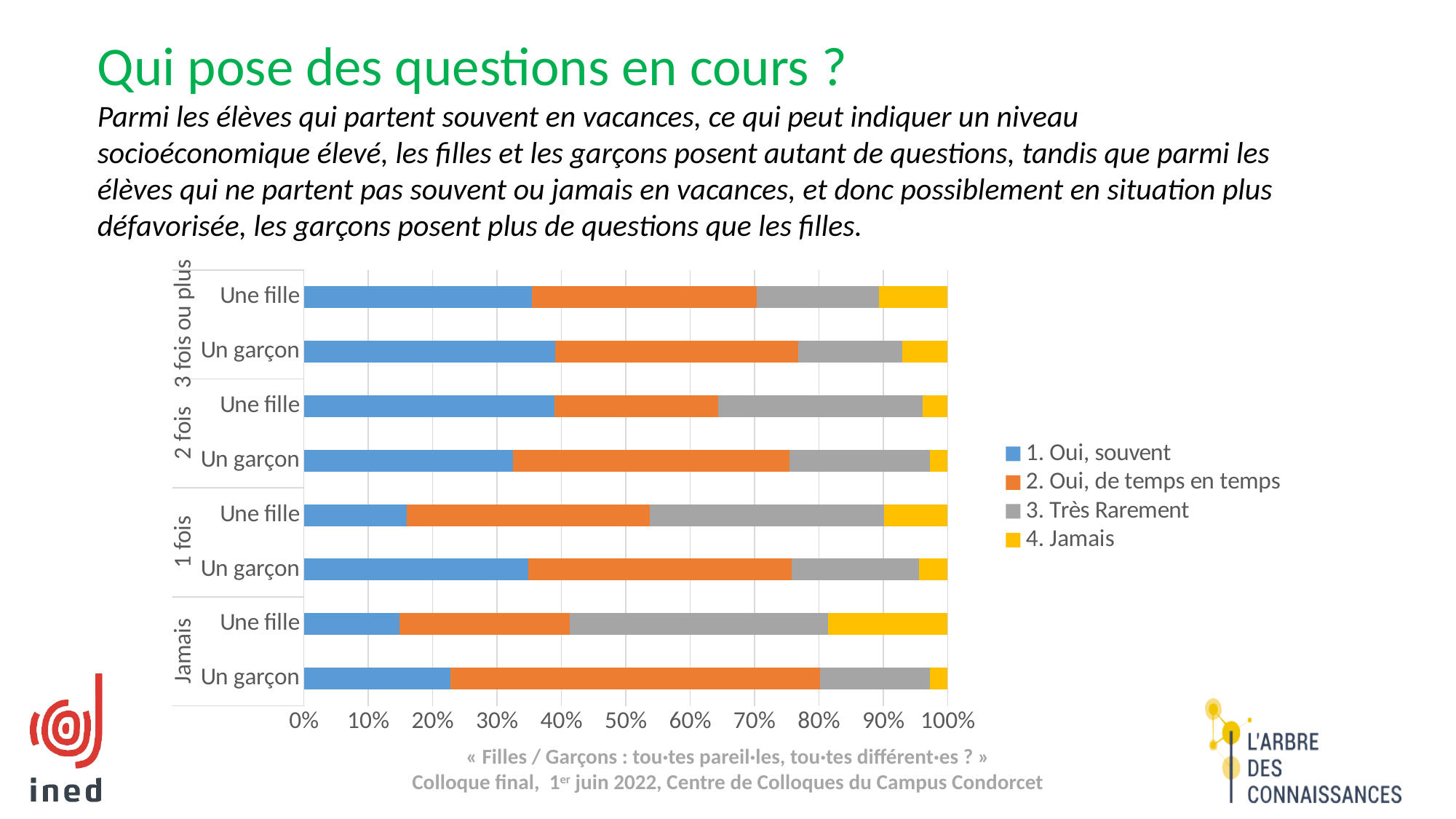
In the 'Jamais' group, who has the larger '1. Oui, souvent' share, 'Une fille' or 'Un garçon'? Un garçon How many bars are plotted in the chart? 8 Is the '1. Oui, souvent' share for 'Un garçon' in the '3 fois ou plus' group greater or less than 30%? greater What kind of chart is shown on the slide? Stacked bar chart Is the '1. Oui, souvent' share for 'Une fille' in the 'Jamais' group greater or less than 20%? less Which bar has the largest '4. Jamais' segment? Une fille (Jamais) What is the first entry in the chart legend? 1. Oui, souvent Is the '1. Oui, souvent' share for 'Une fille' in the '1 fois' group greater or less than 20%? less In the '2 fois' group, who has the larger '1. Oui, souvent' share, 'Une fille' or 'Un garçon'? Une fille In the '1 fois' group, who has the larger '1. Oui, souvent' share, 'Une fille' or 'Un garçon'? Un garçon How many series does the chart legend list? 4 Which colour represents '4. Jamais' in the chart? Yellow